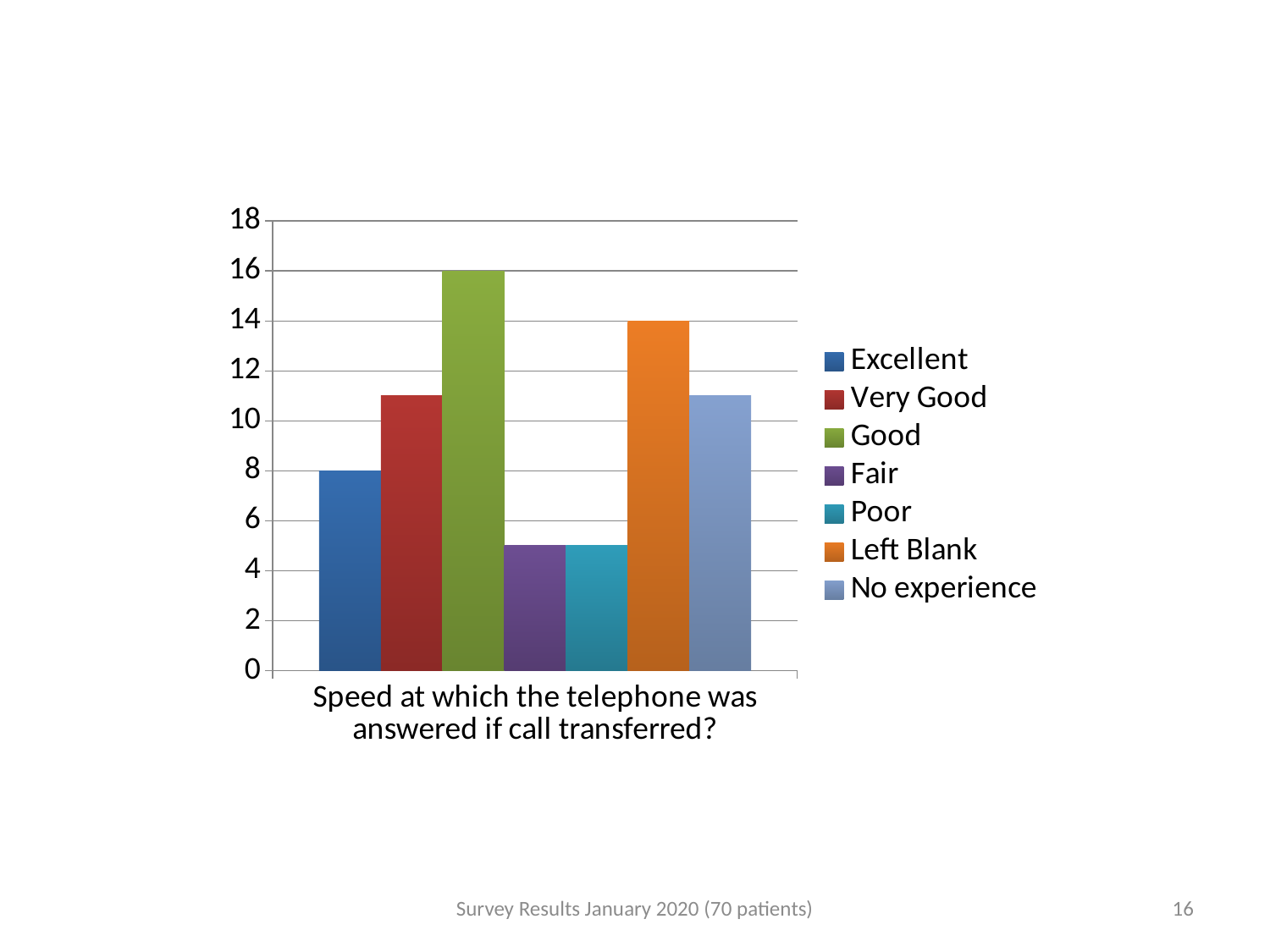
What is the value for Left Blank? 14 Which series has the highest bar? Good What is the difference between the values for Good and Excellent? 8 Is the value for Very Good greater or less than 10? greater What is the difference between the values for Left Blank and Good? 2 Is the value for Fair greater or less than 6? less What is the value for Good? 16 What is the value for Excellent? 8 What is the category label shown on the x axis? Speed at which the telephone was answered if call transferred? Which is larger, the value for Good or the value for Left Blank? Good How many series does the legend list? 7 What type of chart is shown on the slide? bar chart